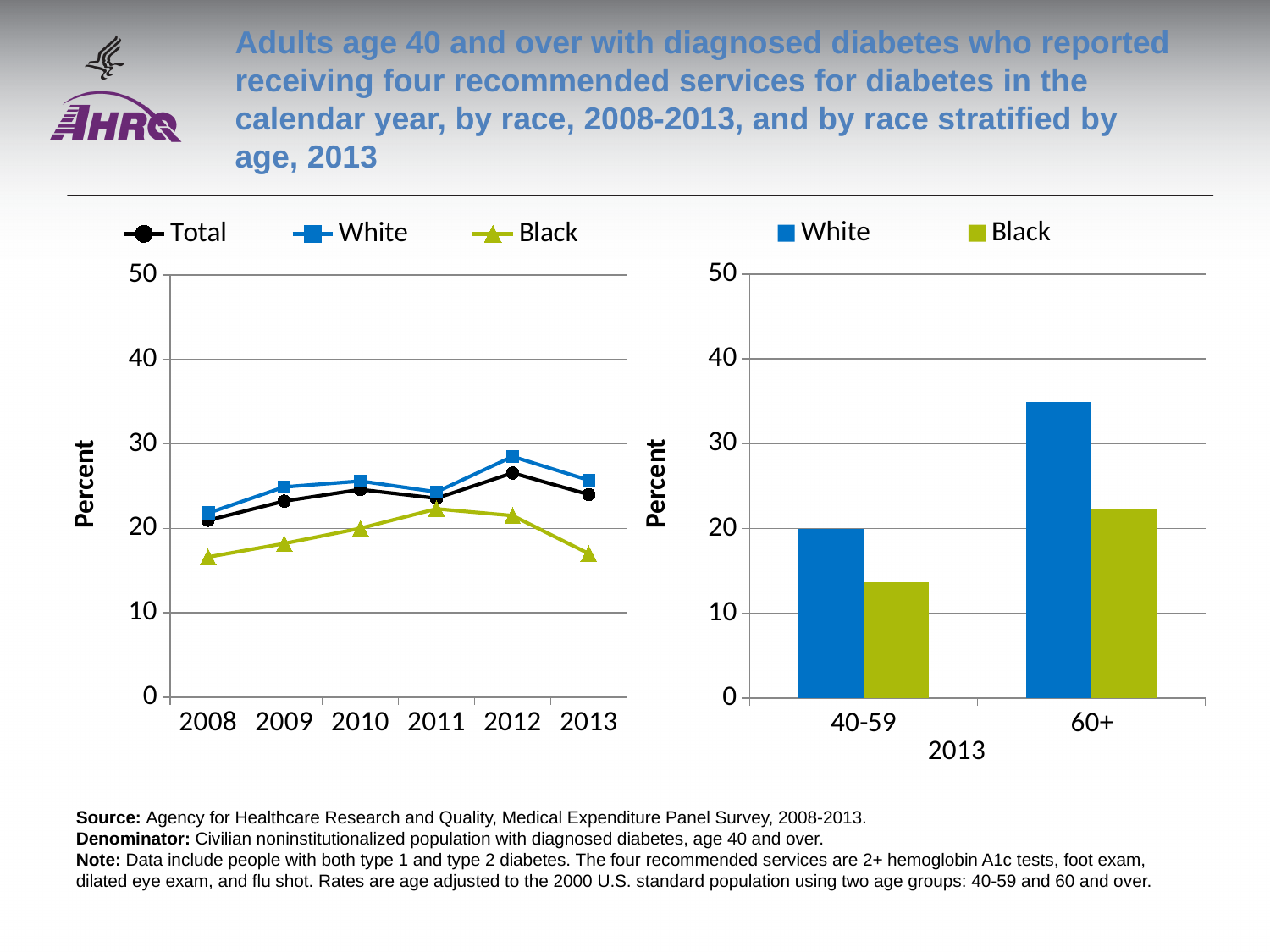
How many years are shown on the x axis of the left chart? 6 In the left chart, does the Black series rise or fall from 2011 to 2013? fall What kind of chart is the chart on the left of the slide? line chart What kind of chart is the chart on the right of the slide? bar chart In the right chart, is the value for White in the 60+ age group greater or less than 30? greater In the right chart, which bar is the lowest? Black, 40-59 In the left chart, in which year is the White series highest? 2012 In the left chart, is the value for Black in 2008 greater or less than 20? less How many series does the legend of the left chart list? 3 In the left chart, which is larger in 2013, the White value or the Black value? White How many series does the legend of the right chart list? 2 In the left chart, is the value for White in 2012 greater or less than 30? less